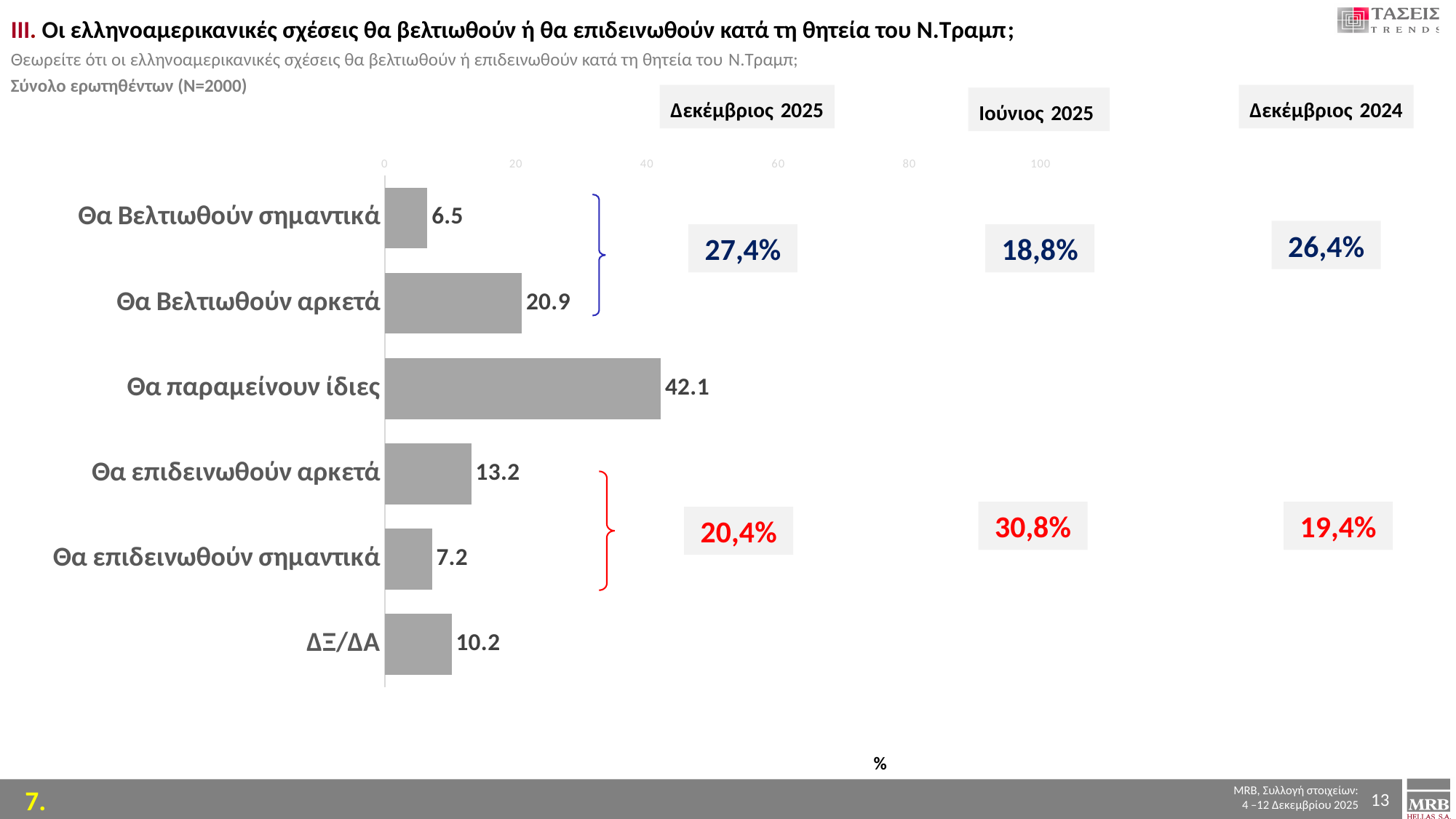
What value is shown for "Θα Βελτιωθούν αρκετά"? 20.9 What is the difference between the values for "Θα επιδεινωθούν αρκετά" and "Θα επιδεινωθούν σημαντικά"? 6.0 Which category has the lowest value in the bar chart? Θα Βελτιωθούν σημαντικά Is the value for "Θα παραμείνουν ίδιες" greater or less than 40? greater How many categories are shown in the bar chart? 6 Which is larger, the value for "Θα Βελτιωθούν αρκετά" or the value for "Θα επιδεινωθούν αρκετά"? Θα Βελτιωθούν αρκετά What value is shown for "ΔΞ/ΔΑ"? 10.2 What value is shown for "Θα παραμείνουν ίδιες"? 42.1 Which category has the highest value in the bar chart? Θα παραμείνουν ίδιες What kind of chart is shown on the slide? bar chart What is the combined value of "Θα Βελτιωθούν σημαντικά" and "Θα Βελτιωθούν αρκετά"? 27.4 What percentage is shown in red for Ιούνιος 2025 in the summary boxes? 30,8%